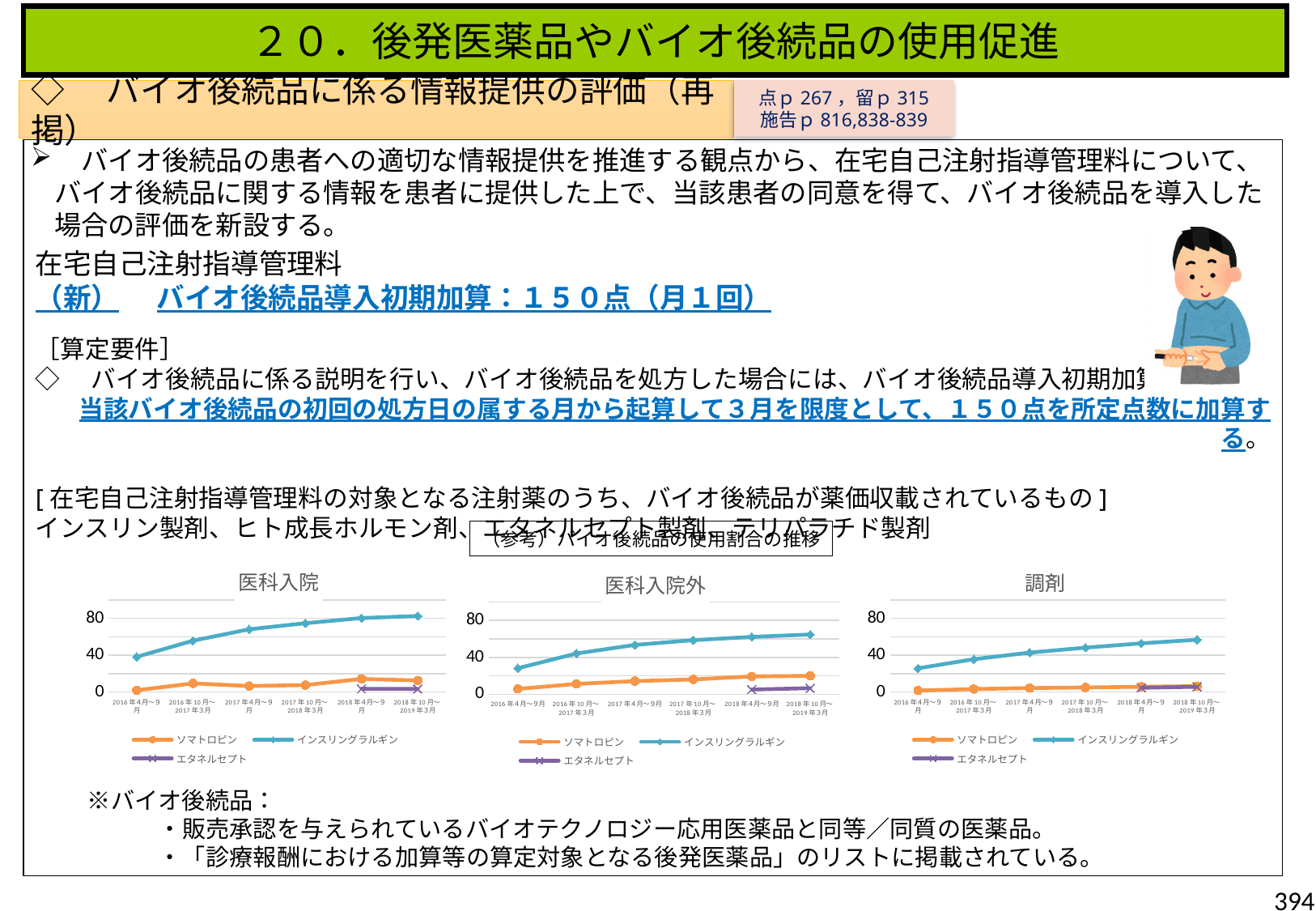
How many time periods are plotted along the x axis of the 調剤 chart? 6 In the 調剤 chart, which series has the highest value at 2018年10月～2019年3月? インスリングラルギン In the 医科入院 chart, is the value for インスリングラルギン at 2016年10月～2017年3月 greater or less than 40? greater What is the title of the rightmost chart on the slide? 調剤 What kind of chart is the 医科入院 chart? line chart In the 医科入院外 chart, which is larger at 2017年4月～9月: the value for インスリングラルギン or the value for ソマトロピン? インスリングラルギン How many series does the legend of the 医科入院外 chart list? 3 In the 医科入院 chart, does the インスリングラルギン line rise or fall from 2016年4月～9月 to 2018年10月～2019年3月? rise In the 医科入院外 chart, which series has the lowest value at 2018年10月～2019年3月? エタネルセプト In the 調剤 chart, is the value for インスリングラルギン at 2018年10月～2019年3月 greater or less than 80? less In the 医科入院 chart, is the value for ソマトロピン at 2018年4月～9月 greater or less than 40? less